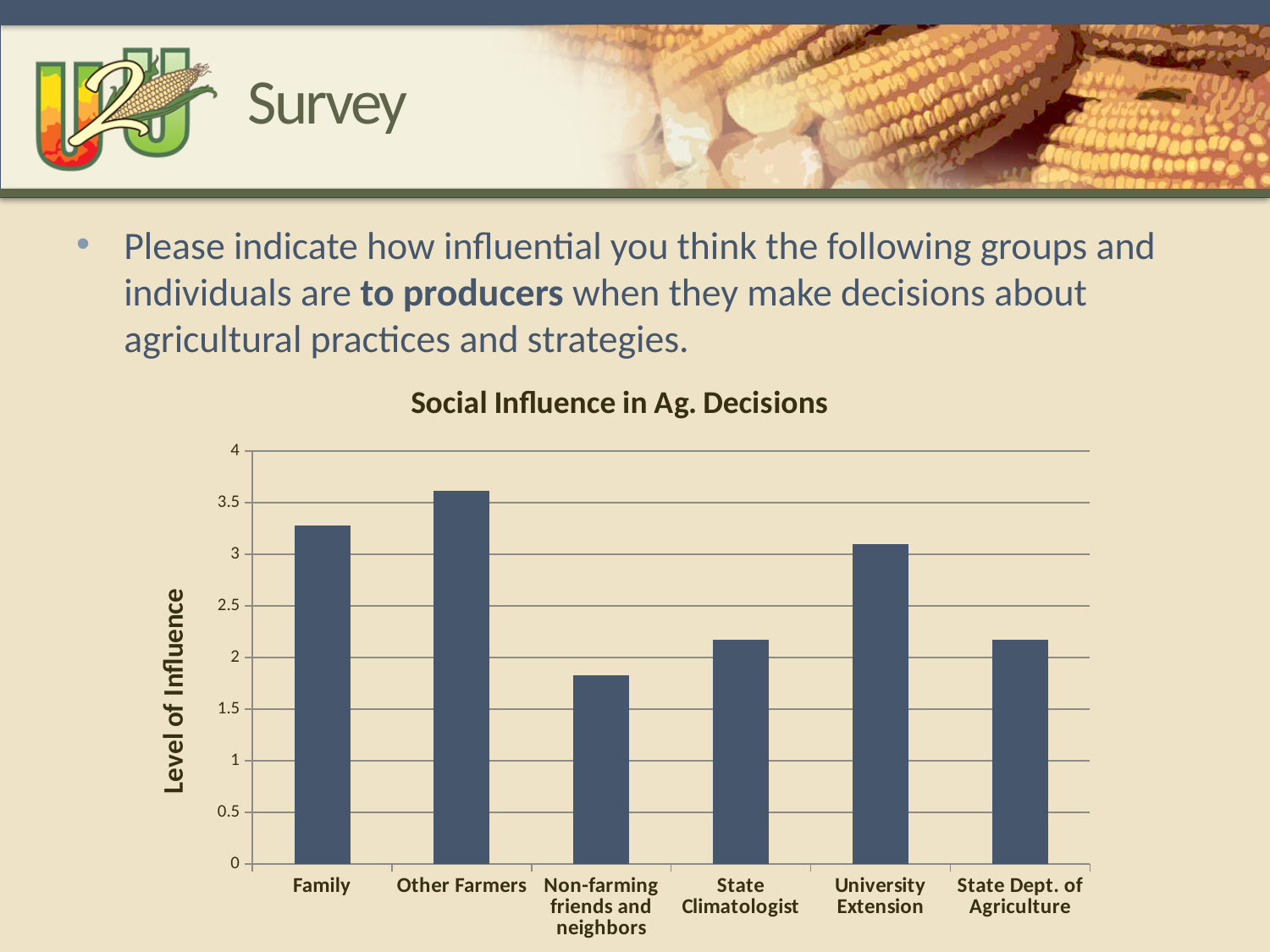
Which category has the highest level of influence? Other Farmers Is the value for Other Farmers greater or less than 3.5? greater What is the label of the vertical axis? Level of Influence Is the value for Family greater or less than 3.5? less Is the value for University Extension greater or less than 3? greater Which has a higher level of influence, State Climatologist or Non-farming friends and neighbors? State Climatologist What is the title of the chart? Social Influence in Ag. Decisions Which has a higher level of influence, Family or University Extension? Family What type of chart is shown on the slide? bar chart Which category has the lowest level of influence? Non-farming friends and neighbors How many categories are shown on the chart? 6